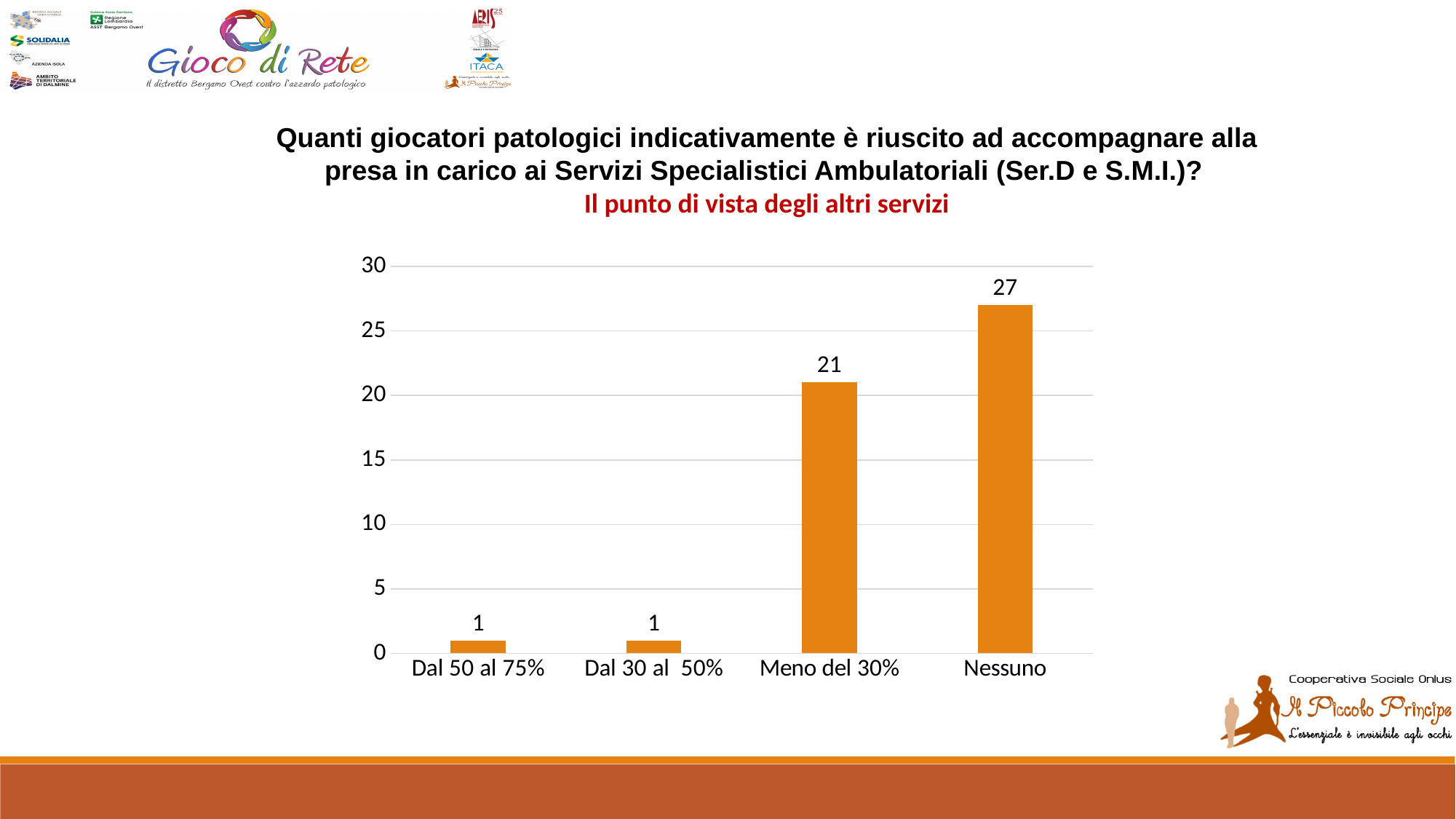
What is the value for "Meno del 30%"? 21 What is the value for "Dal 50 al 75%"? 1 Is the value for "Nessuno" greater or less than 25? greater What is the value for "Nessuno"? 27 Do the values rise or fall from left to right along the x axis? rise What kind of chart is shown on the slide? bar chart What is the total of all four bars? 50 What colour are the bars in the chart? orange How many categories are shown on the x axis? 4 Which is larger, the value for "Meno del 30%" or the value for "Dal 30 al 50%"? Meno del 30% Which category has the highest value? Nessuno What is the difference between the values for "Nessuno" and "Meno del 30%"? 6